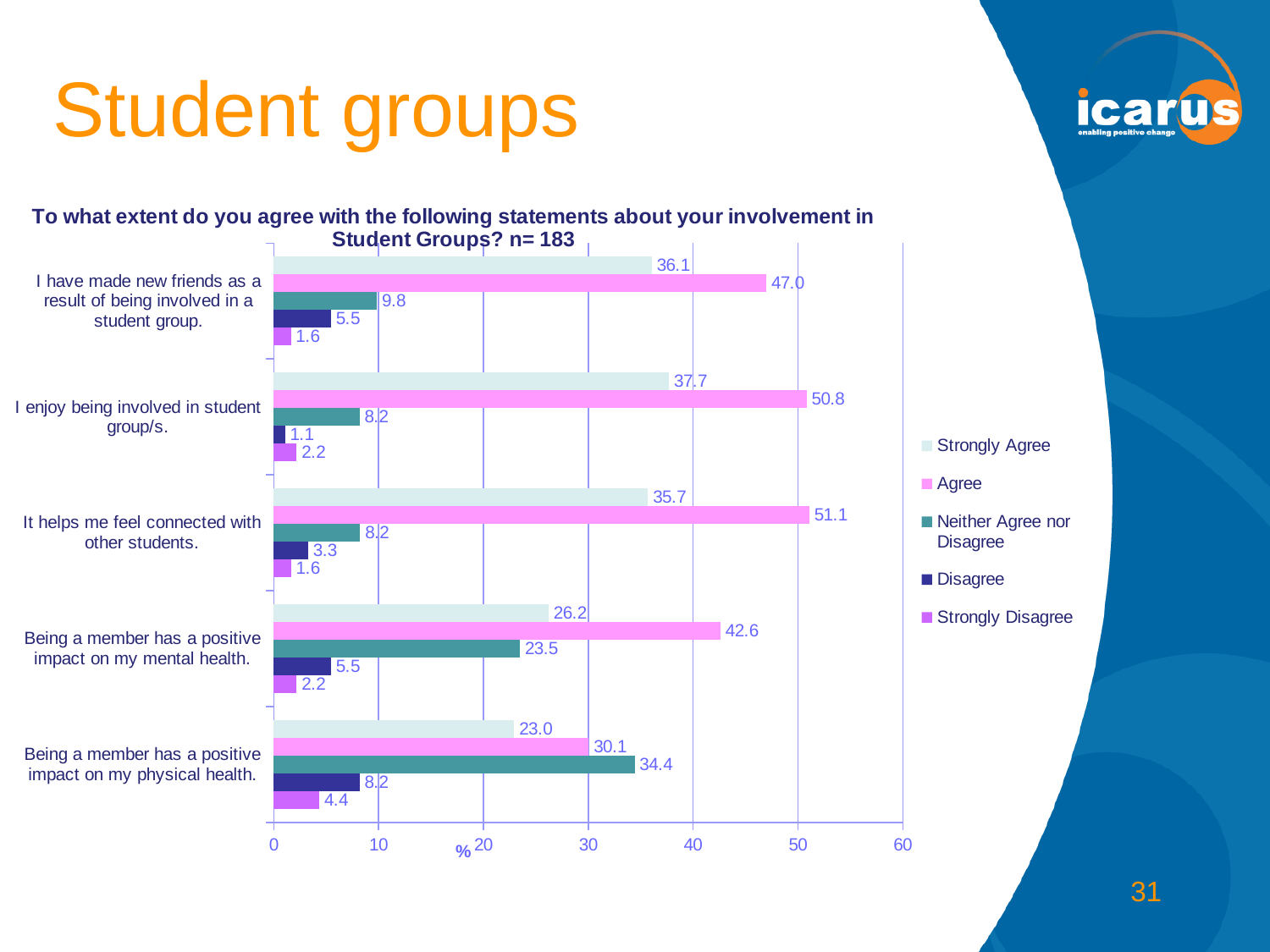
What is the 'Agree' value for 'It helps me feel connected with other students.'? 51.1 What is the 'Neither Agree nor Disagree' value for 'Being a member has a positive impact on my mental health.'? 23.5 Which statement has the lowest 'Strongly Agree' value? Being a member has a positive impact on my physical health. For 'Being a member has a positive impact on my physical health.', which is larger: 'Agree' or 'Neither Agree nor Disagree'? Neither Agree nor Disagree What kind of chart is shown on the slide? Bar chart How many statements (categories) are shown on the chart? 5 Which statement has the highest 'Agree' value? It helps me feel connected with other students. What is the difference between the 'Agree' and 'Strongly Agree' values for 'I enjoy being involved in student group/s.'? 13.1 How many series does the legend list? 5 What is the sample size (n) stated in the chart title? 183 What is the 'Strongly Disagree' value for 'Being a member has a positive impact on my physical health.'? 4.4 What is the 'Strongly Agree' value for 'Being a member has a positive impact on my physical health.'? 23.0